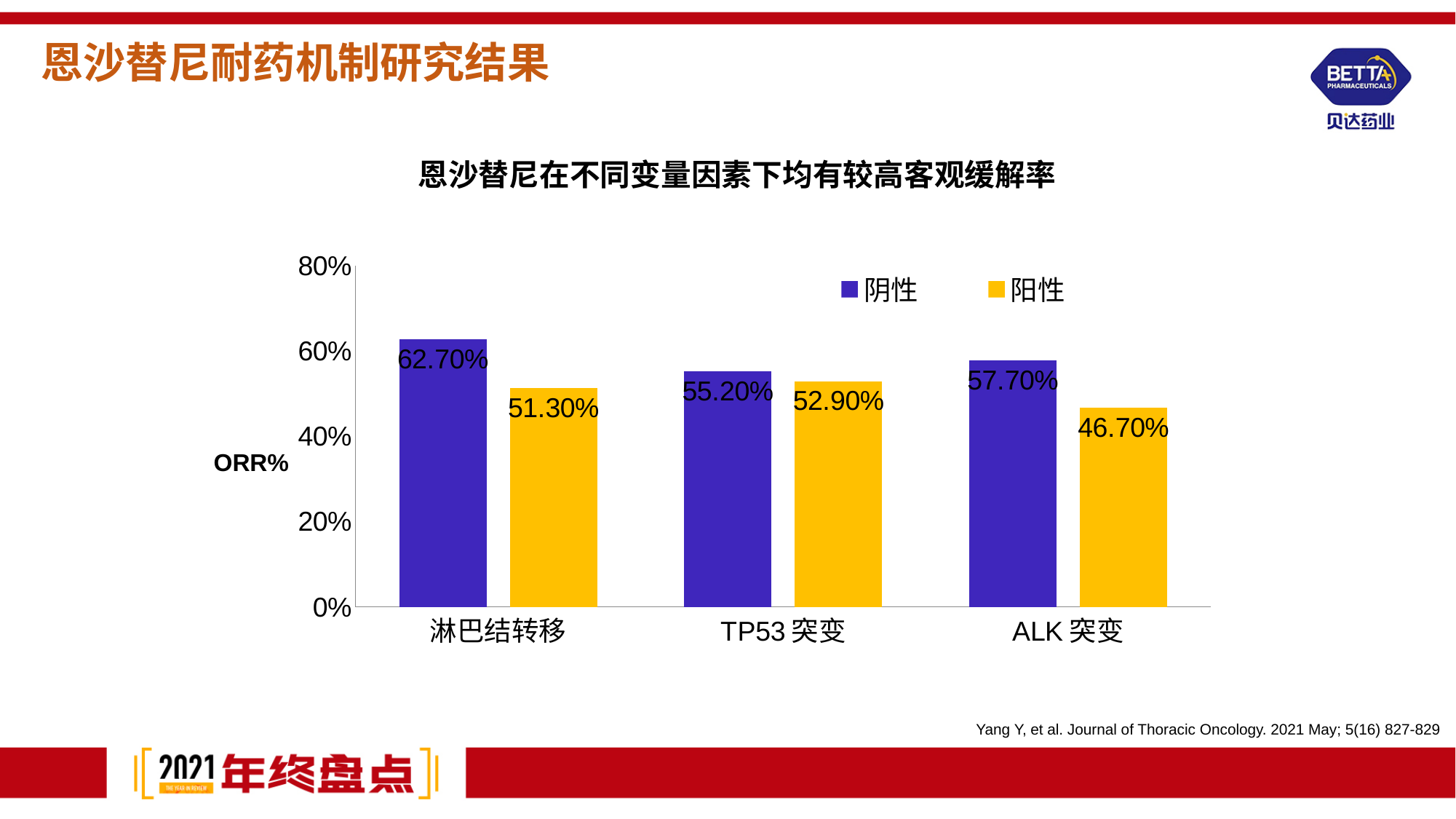
What is the difference between the 阴性 and 阳性 values for 淋巴结转移? 11.40% What is the ORR% for 阴性 in the 淋巴结转移 category? 62.70% What is the ORR% for 阳性 in the ALK 突变 category? 46.70% Which is larger, the 阴性 value for TP53 突变 or the 阳性 value for TP53 突变? 阴性 How many series does the legend list? 2 How many categories are shown on the x axis? 3 Which category has the lowest 阳性 value? ALK 突变 What kind of chart is shown on the slide? bar chart What is the label on the vertical axis of the chart? ORR% What is the ORR% for 阳性 in the TP53 突变 category? 52.90% What is the difference between the 阴性 and 阳性 values for ALK 突变? 11.00% Which category has the highest 阴性 value? 淋巴结转移